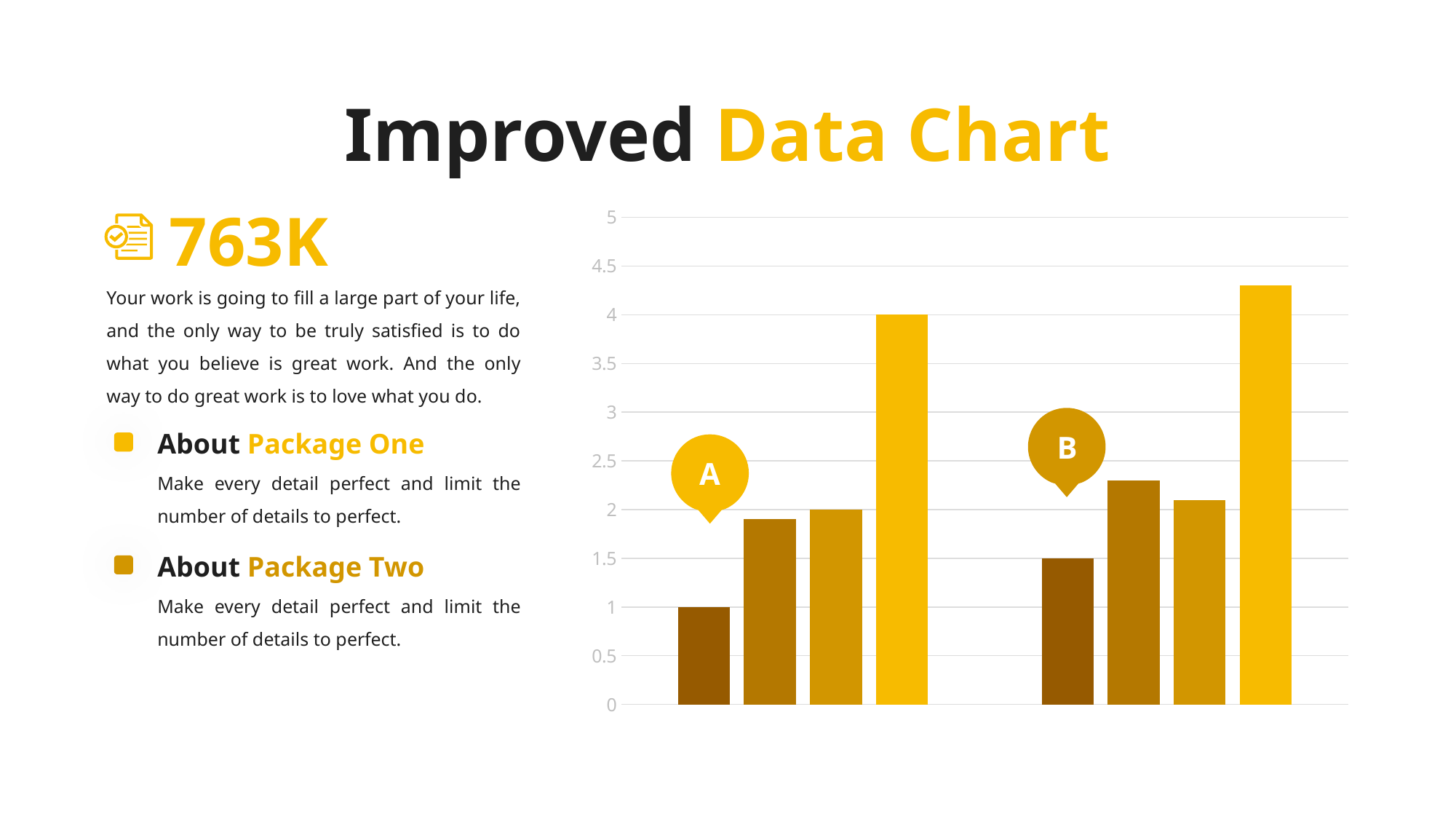
What is the value of the third bar from the left in group A? 2 What is the value of the shortest bar in group B? 1.5 How many bars are in group A? 4 Is the value of the tallest bar in group B greater or less than 4? greater What is the value of the tallest bar in group A? 4 Which group, A or B, contains the tallest bar on the chart? B Is the value of the second bar from the left in group B greater or less than 2? greater What kind of chart is shown on the slide? bar chart How many labelled groups of bars does the chart show? 2 What is the difference between the tallest and shortest bars in group A? 3 What is the value of the shortest bar in group A? 1 Which is larger: the shortest bar in group A or the shortest bar in group B? the shortest bar in group B